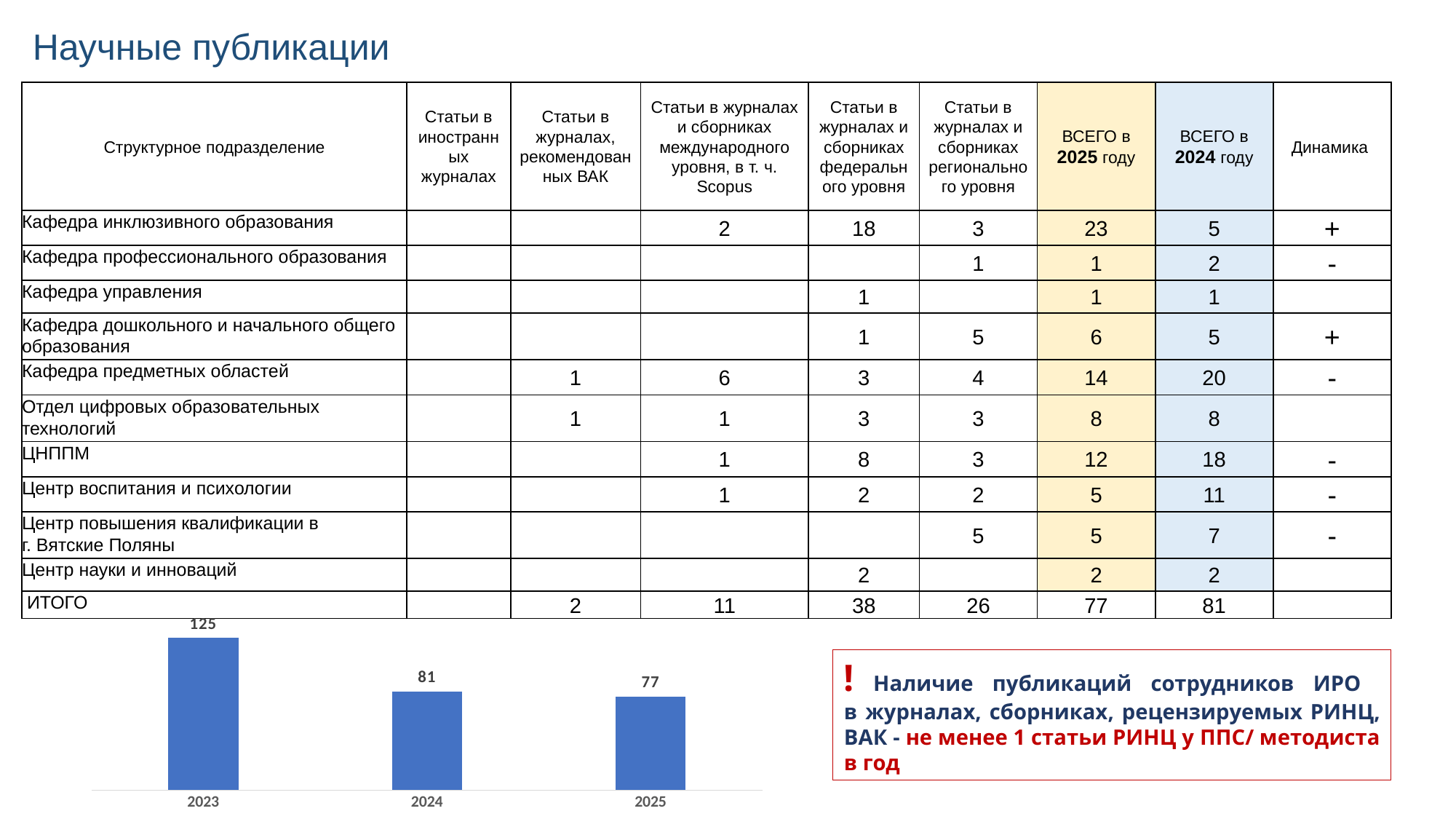
What is the value of the bar for 2023 in the bar chart at the bottom of the slide? 125 In the bar chart at the bottom of the slide, what is the difference between the values for 2023 and 2024? 44 In the bar chart at the bottom of the slide, what is the difference between the values for 2024 and 2025? 4 What is the value of the bar for 2025 in the bar chart at the bottom of the slide? 77 In the bar chart at the bottom of the slide, which is larger: the value for 2023 or the value for 2025? 2023 What type of chart is shown at the bottom left of the slide? Bar chart What colour are the bars in the bar chart at the bottom of the slide? Blue In the bar chart at the bottom of the slide, do the values rise or fall from 2023 to 2025? Fall In the bar chart at the bottom of the slide, which year has the highest value? 2023 What is the value of the bar for 2024 in the bar chart at the bottom of the slide? 81 In the bar chart at the bottom of the slide, which year has the lowest value? 2025 How many bars are shown in the bar chart at the bottom of the slide? 3